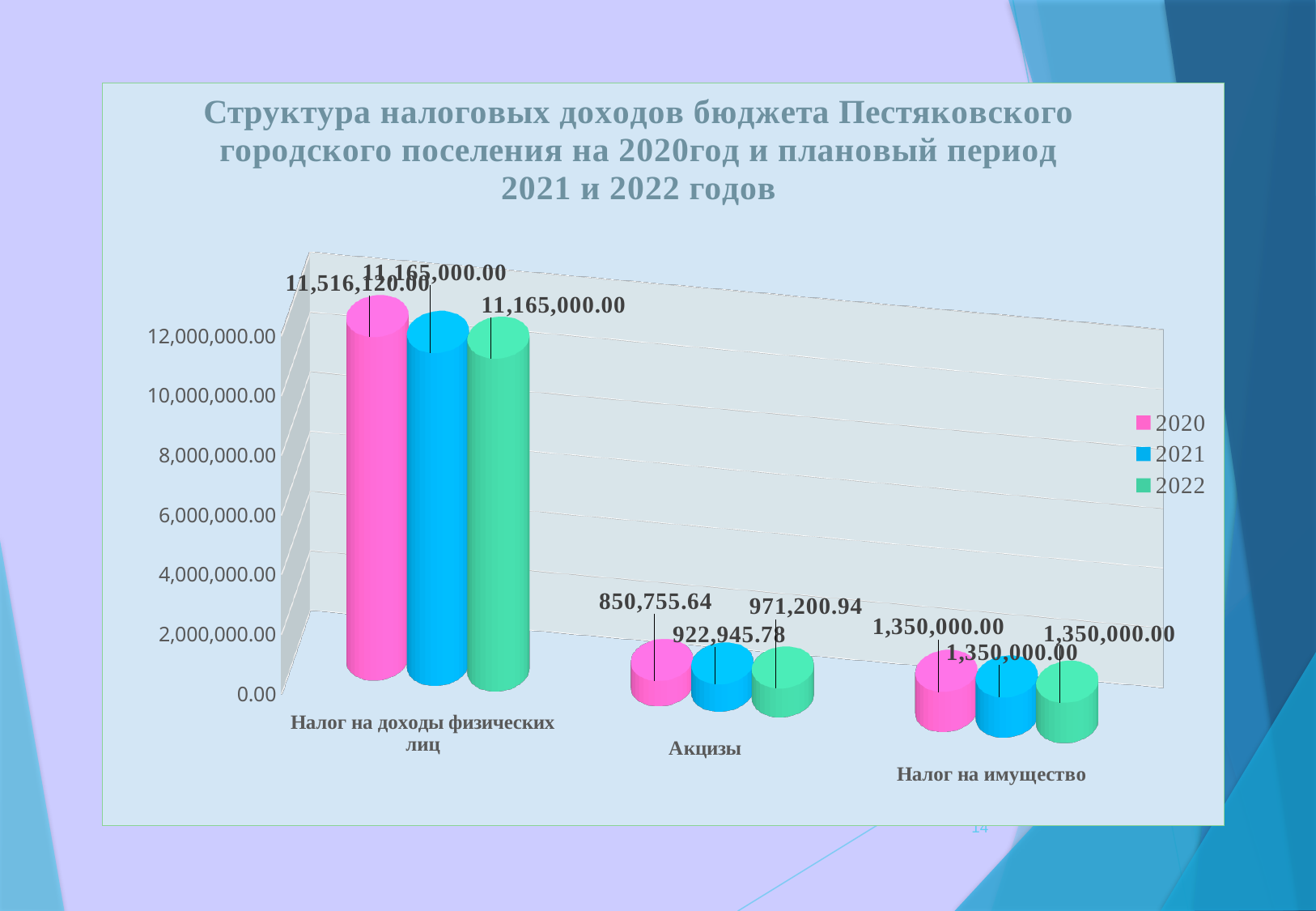
Which category has the highest value in 2020? Налог на доходы физических лиц What is the value for Акцизы in 2022? 971,200.94 What is the value for Налог на имущество in 2022? 1,350,000.00 What kind of chart is shown on the slide? bar chart What is the difference between the 2020 and 2021 values for Налог на доходы физических лиц? 351,120.00 Is the value for Налог на имущество in 2020 greater or less than 2,000,000.00? less What is the value for Акцизы in 2021? 922,945.78 How many series does the legend list? 3 How many categories are shown on the x axis? 3 Which category has the lowest value in 2021? Акцизы Which is larger for Акцизы: the 2020 value or the 2022 value? 2022 What is the value for Налог на доходы физических лиц in 2020? 11,516,120.00